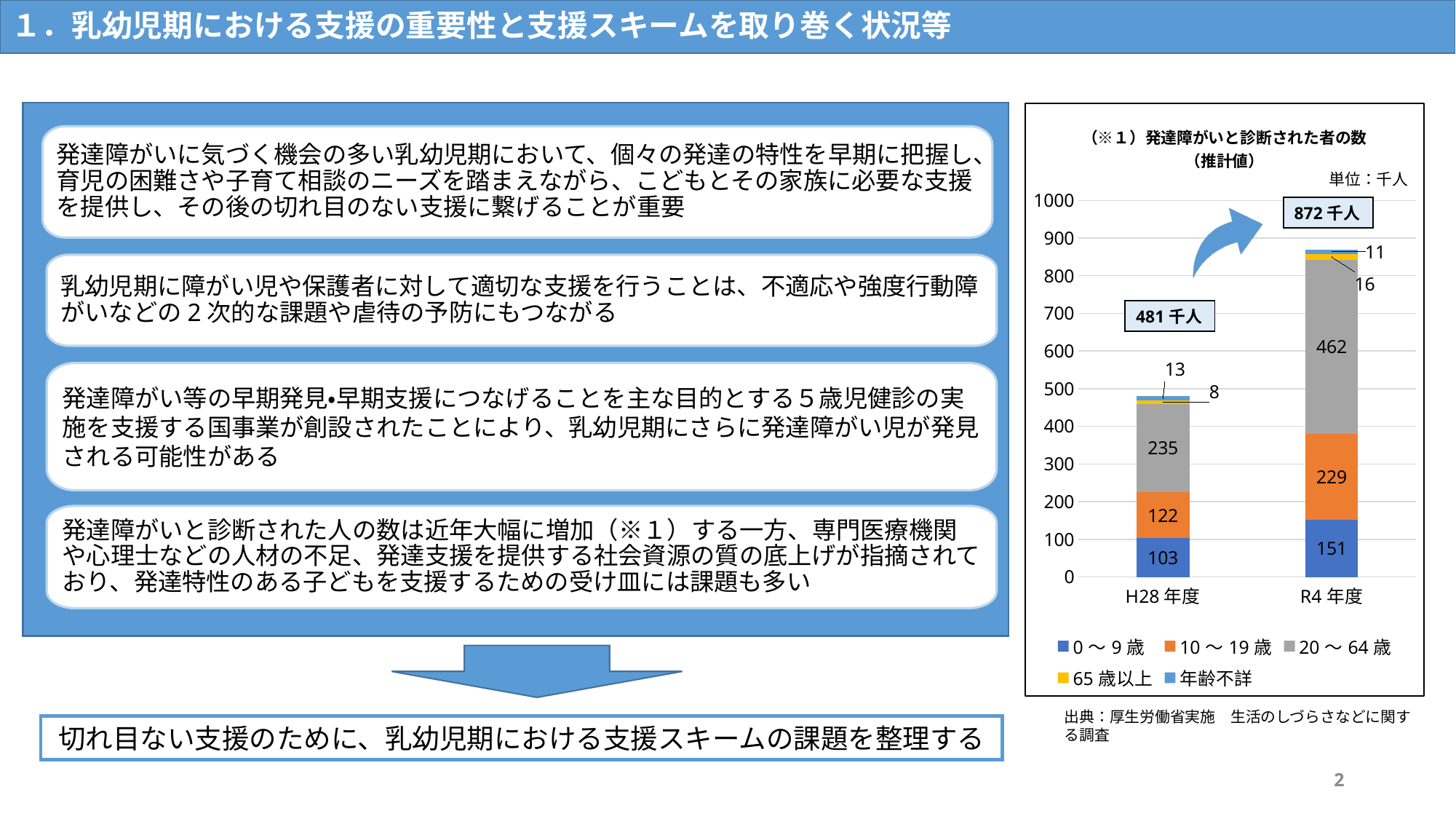
What is the value for 0～9歳 in R4年度? 151 How many series does the legend list? 5 What is the value for 10～19歳 in R4年度? 229 What is the total of the stacked bar for H28年度? 481 千人 What is the difference between the 20～64歳 values for R4年度 and H28年度? 227 What is the total of the stacked bar for R4年度? 872 千人 What is the value for 20～64歳 in H28年度? 235 What unit is stated for the chart values? 千人 What kind of chart is shown on the slide? Stacked bar chart What is the value for 65歳以上 in H28年度? 8 Which age group has the highest value in R4年度? 20～64歳 Which is larger, the 0～9歳 value for H28年度 or for R4年度? R4年度